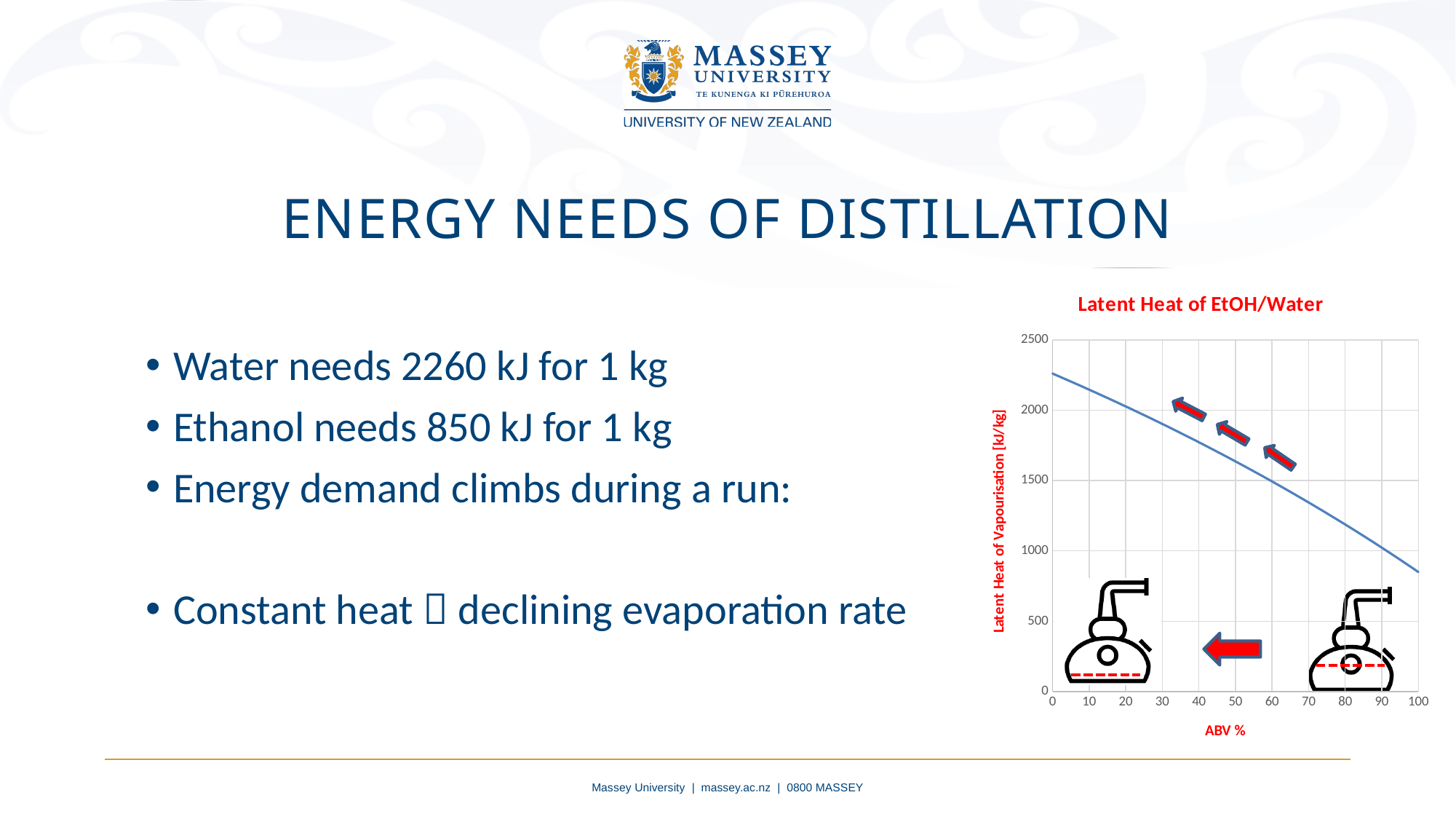
Is the latent heat value at 50 ABV % greater or less than 1000? greater Is the latent heat value at 80 ABV % greater or less than 1500? less Is the latent heat value at 20 ABV % greater or less than 1500? greater What is the title of the chart? Latent Heat of EtOH/Water Which has the higher latent heat on the chart, 10 ABV % or 90 ABV %? 10 ABV % What is the label of the x axis of the chart? ABV % Do the values on the chart rise or fall as ABV % increases? fall What kind of chart is shown on the slide? line chart What is the highest value shown on the y axis of the chart? 2500